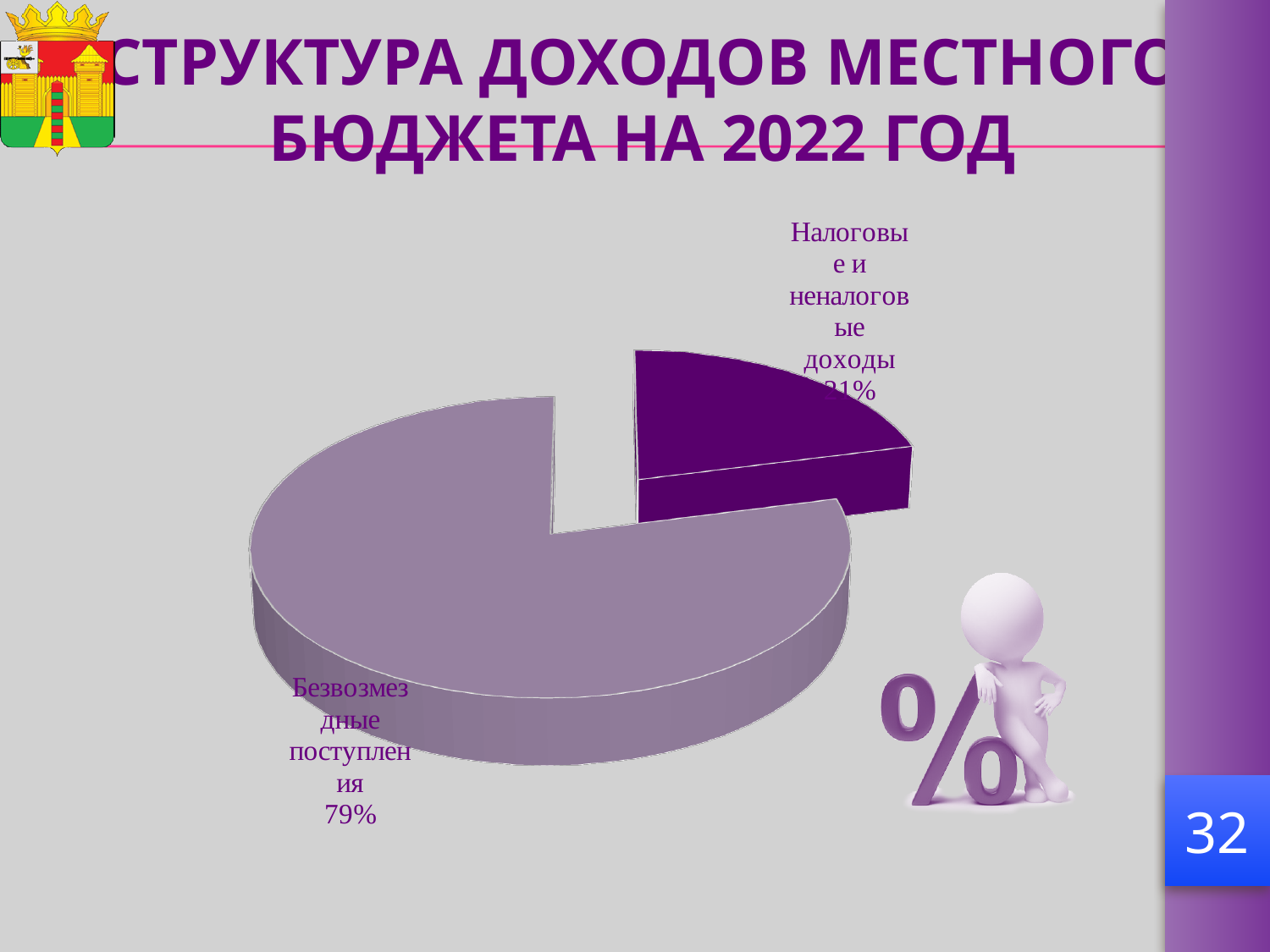
What kind of chart is shown on the slide? pie chart Which category has the smallest slice of the pie? Налоговые и неналоговые доходы What is the title of the slide containing the chart? СТРУКТУРА ДОХОДОВ МЕСТНОГО БЮДЖЕТА НА 2022 ГОД How many slices does the pie chart have? 2 Which is larger: "Безвозмездные поступления" or "Налоговые и неналоговые доходы"? Безвозмездные поступления Which slice is drawn in dark purple? Налоговые и неналоговые доходы Which category has the largest slice of the pie? Безвозмездные поступления What is the value shown for "Безвозмездные поступления"? 79% What share of the pie does "Безвозмездные поступления" account for? 79%